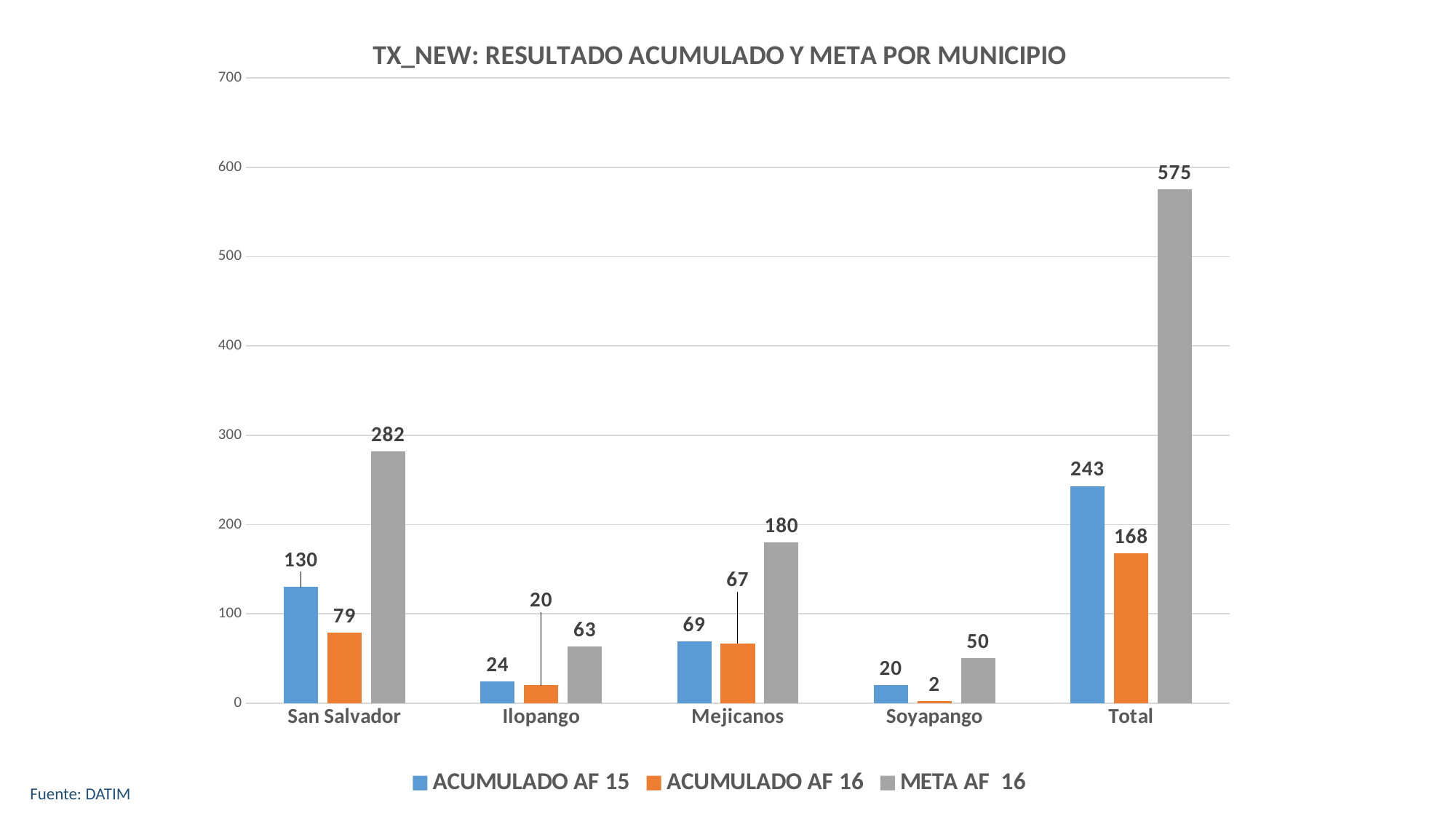
What is the title of the chart? TX_NEW: RESULTADO ACUMULADO Y META POR MUNICIPIO How many series does the legend list? 3 What kind of chart is shown on the slide? bar chart What is the difference between the META AF 16 and ACUMULADO AF 16 values for Total? 407 What is the ACUMULADO AF 16 value for Soyapango? 2 Which is larger for Ilopango: ACUMULADO AF 15 or ACUMULADO AF 16? ACUMULADO AF 15 What is the ACUMULADO AF 15 value for Mejicanos? 69 Is the META AF 16 value for Mejicanos greater or less than 200? less What is the META AF 16 value for San Salvador? 282 Among the four municipalities (excluding Total), which has the lowest ACUMULADO AF 16 value? Soyapango Which category has the highest META AF 16 value? Total How many categories are shown on the x axis? 5